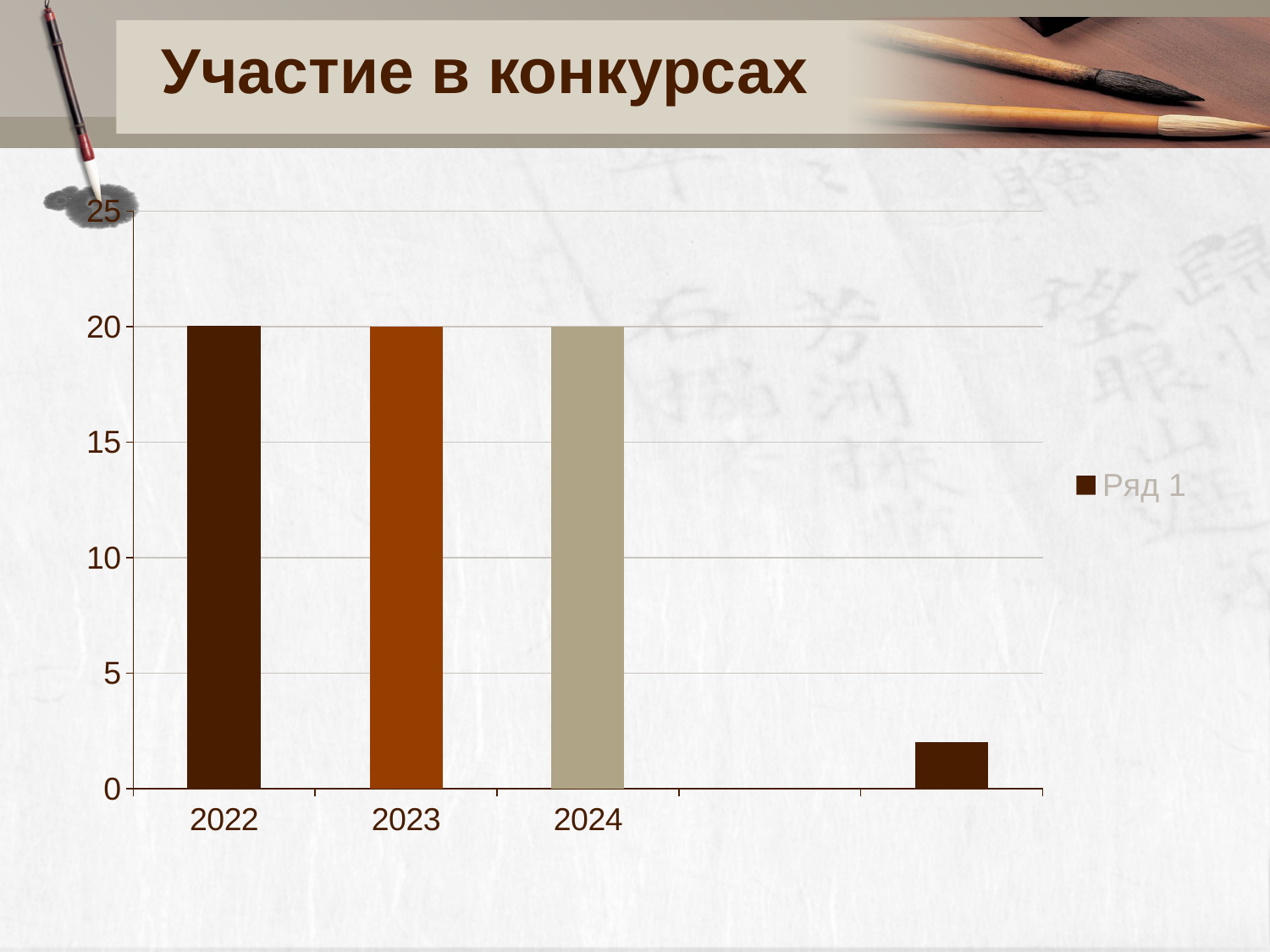
Do the values rise, fall or stay the same from 2022 to 2024? stay the same What is the value for 2022? 20 What is the highest value shown on the vertical axis? 25 Is the value for 2022 greater or less than 15? greater What kind of chart is shown on the slide? bar chart How many series does the legend list? 1 How many years are labeled on the x axis? 3 What is the value for 2024? 20 What is the title of the slide containing the chart? Участие в конкурсах Is the value for 2024 greater or less than 25? less What is the legend entry shown on the chart? Ряд 1 What is the value for 2023? 20